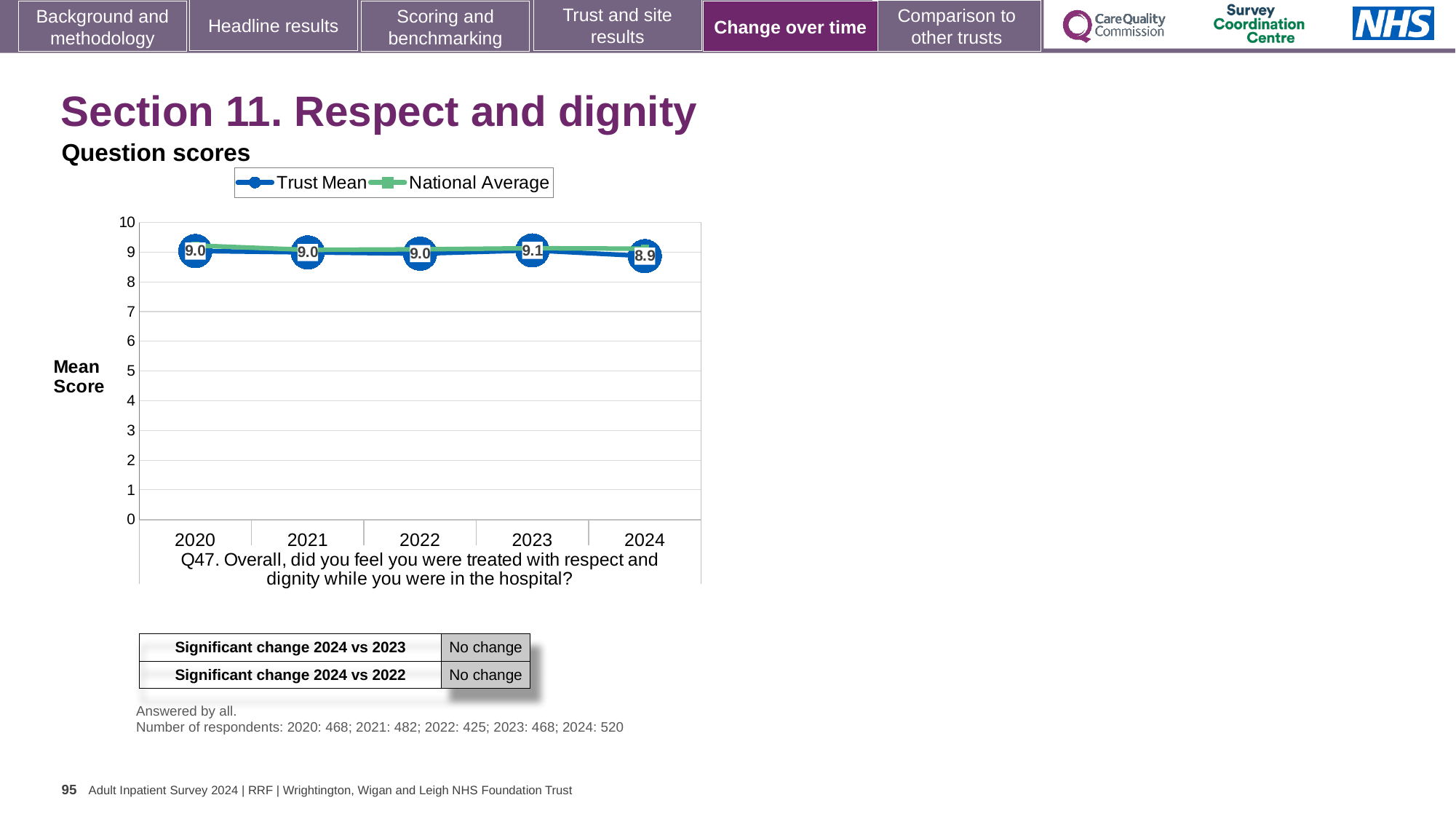
What is the Trust Mean score for 2023? 9.1 In which year is the Trust Mean score highest? 2023 What is the Trust Mean score for 2024? 8.9 Is the National Average for 2024 greater or less than 8? greater What is the label on the y axis? Mean Score Is the Trust Mean score for 2022 greater or less than 8? greater What is the difference between the Trust Mean scores for 2023 and 2024? 0.2 What is the Trust Mean score for 2020? 9.0 What kind of chart is shown? Line chart How many series does the legend list? 2 In which year is the Trust Mean score lowest? 2024 How many years are shown on the x axis? 5